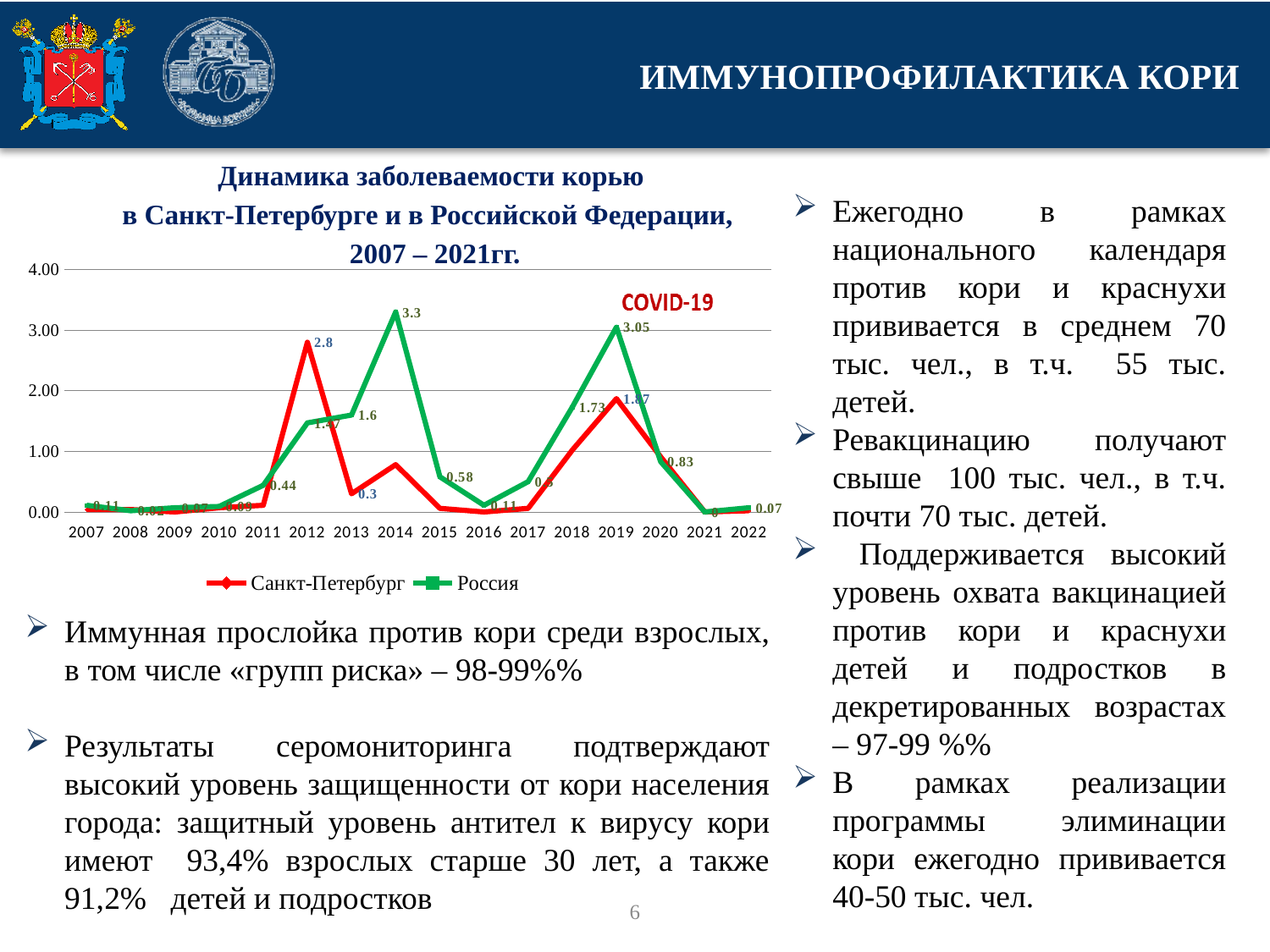
How many years are plotted along the x axis of the chart? 16 What is the value for Россия in 2014? 3.3 What is the difference between the Россия values in 2014 and 2019? 0.25 In which year does the Санкт-Петербург series reach its highest value? 2012 What are the two series named in the chart legend? Санкт-Петербург and Россия How many series does the chart legend list? 2 In which year does the Россия series reach its highest value? 2014 What is the value for Россия in 2019? 3.05 What kind of chart is shown on the slide? line chart Is the value for Санкт-Петербург in 2012 greater or less than 3.00? less What is the value for Санкт-Петербург in 2012? 2.8 In 2019, which series has the higher value, Санкт-Петербург or Россия? Россия